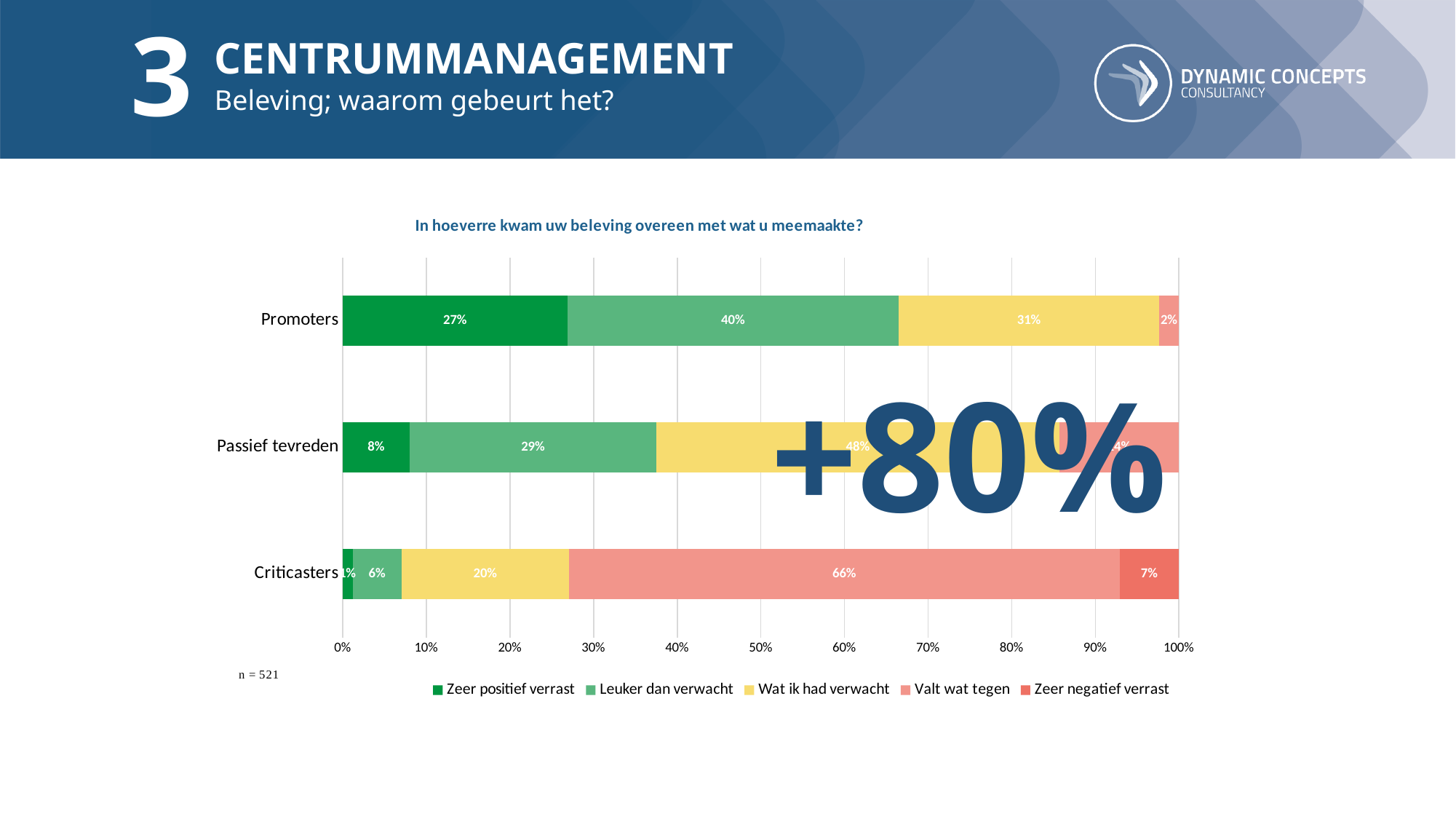
What is the difference between the 'Wat ik had verwacht' values for Promoters and Criticasters? 11% How many series does the legend list? 5 What is the value for 'Zeer negatief verrast' in the Criticasters bar? 7% What is the value for 'Leuker dan verwacht' in the Promoters bar? 40% What kind of chart is shown on the slide? Stacked bar chart What is the title of the chart? In hoeverre kwam uw beleving overeen met wat u meemaakte? How many categories are shown on the vertical axis? 3 What is the value for 'Valt wat tegen' in the Criticasters bar? 66% What is the value for 'Zeer positief verrast' in the Promoters bar? 27% Which category has the highest value for 'Zeer positief verrast'? Promoters What is the value for 'Leuker dan verwacht' in the Passief tevreden bar? 29% Which is larger: 'Leuker dan verwacht' for Promoters or for Criticasters? Promoters